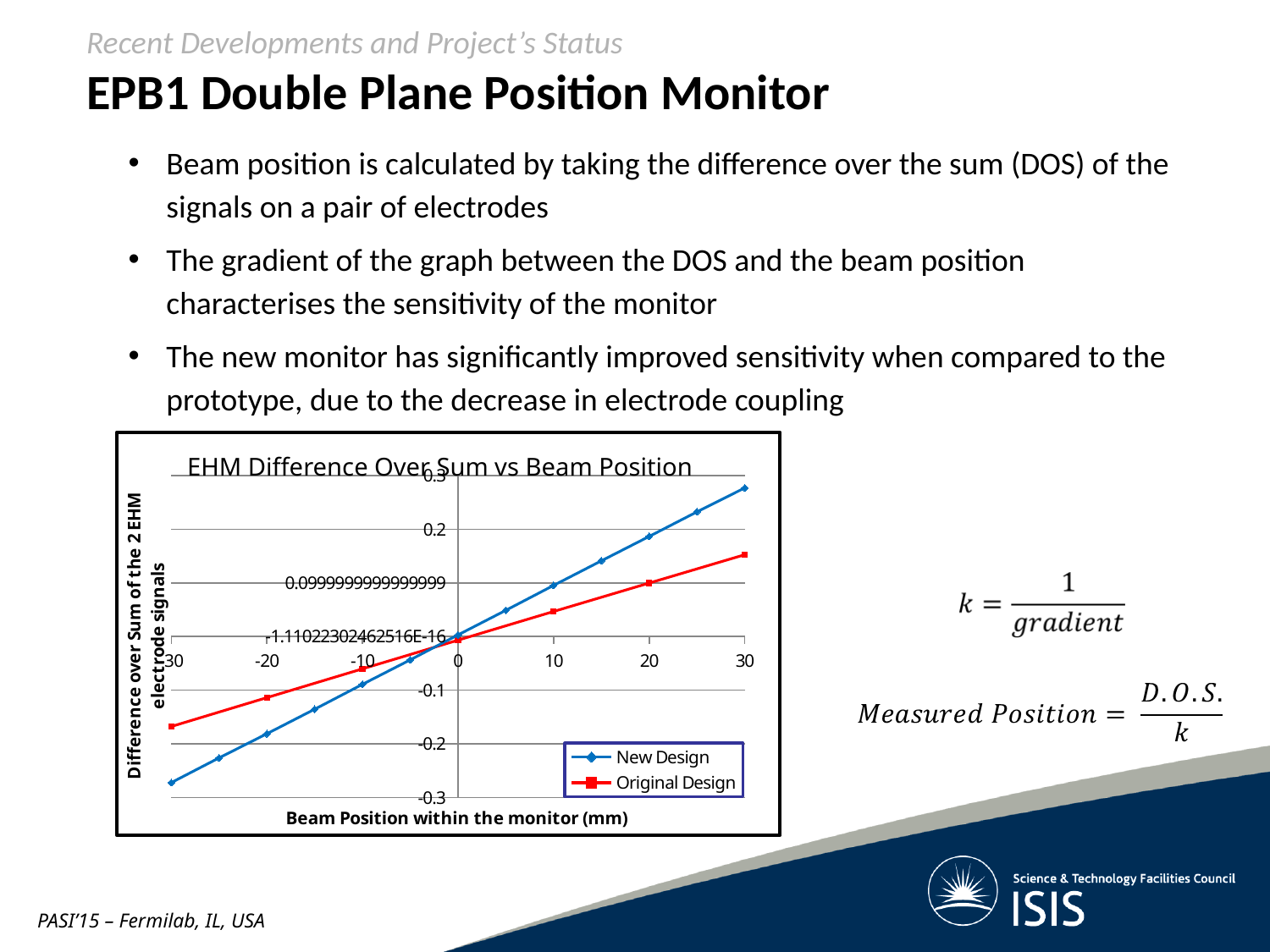
Is the New Design value at a beam position of -30 mm greater or less than -0.2? less How many data points are plotted for the New Design series? 13 At a beam position of 30 mm, which series has the larger value, New Design or Original Design? New Design How many series does the chart legend list? 2 Is the New Design value at a beam position of 30 mm greater or less than 0.2? greater Do the New Design values rise or fall as the beam position increases from -30 to 30? rise What are the two series named in the chart legend? New Design and Original Design At a beam position of -30 mm, which series has the lower value, New Design or Original Design? New Design What is the title of the chart? EHM Difference Over Sum vs Beam Position Is the Original Design value at a beam position of -30 mm greater or less than -0.2? greater What kind of chart is shown on the slide? line chart